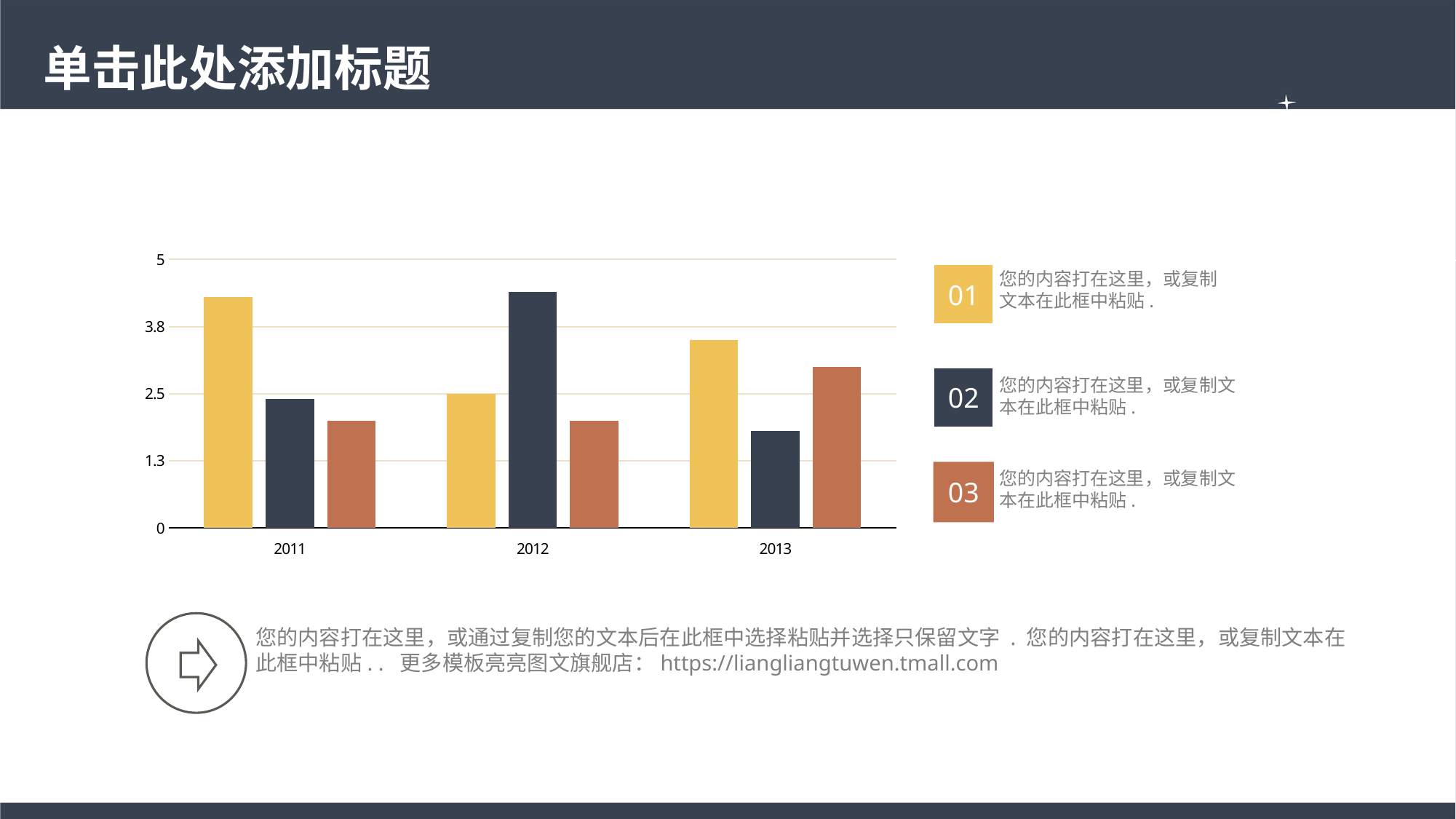
How many years are shown on the x axis of the chart? 3 Is the value of the dark navy bar for 2012 greater or less than 3.8? greater What is the value of the yellow bar for 2012? 2.5 For 2012, which bar is taller, the dark navy bar or the orange bar? the dark navy bar In which year is the dark navy bar the shortest? 2013 How many bars are shown for each year in the chart? 3 In which year is the yellow bar the tallest? 2011 Is the value of the orange bar for 2013 greater or less than 2.5? greater What is the highest value shown on the y axis of the chart? 5 Is the value of the yellow bar for 2011 greater or less than 3.8? greater What type of chart is shown on the slide? bar chart